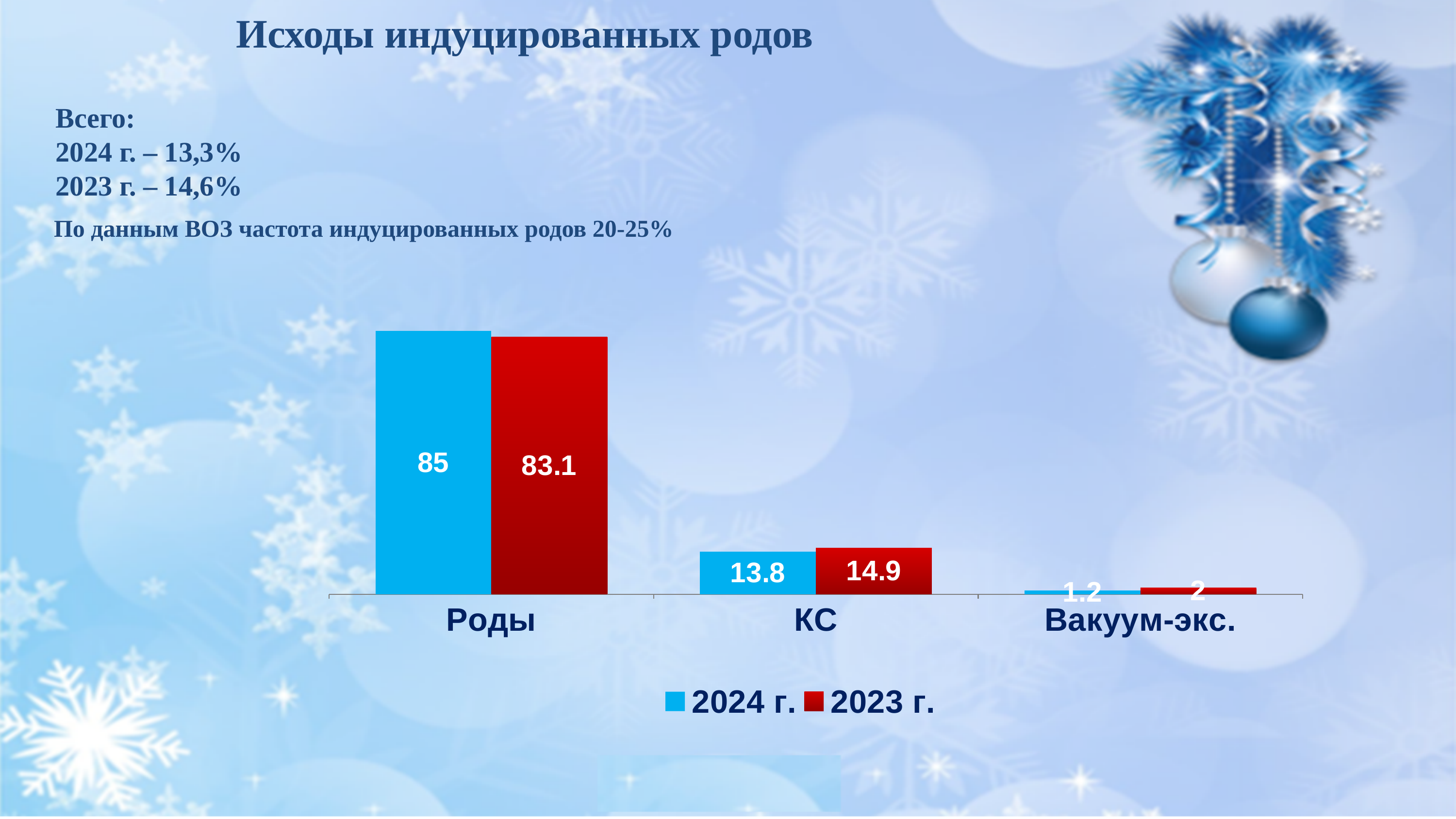
What is the value for КС in the 2023 г. series? 14.9 For КС, which series has the larger value, 2024 г. or 2023 г.? 2023 г. How many categories are shown on the x axis? 3 What is the value for КС in the 2024 г. series? 13.8 What is the value for Роды in the 2024 г. series? 85 What is the value for Вакуум-экс. in the 2023 г. series? 2 What is the difference between the 2024 г. and 2023 г. values for Роды? 1.9 Which category has the highest value in the 2024 г. series? Роды What kind of chart is shown on the slide? Bar chart How many series does the legend list? 2 What is the value for Роды in the 2023 г. series? 83.1 Which category has the lowest value in the 2023 г. series? Вакуум-экс.